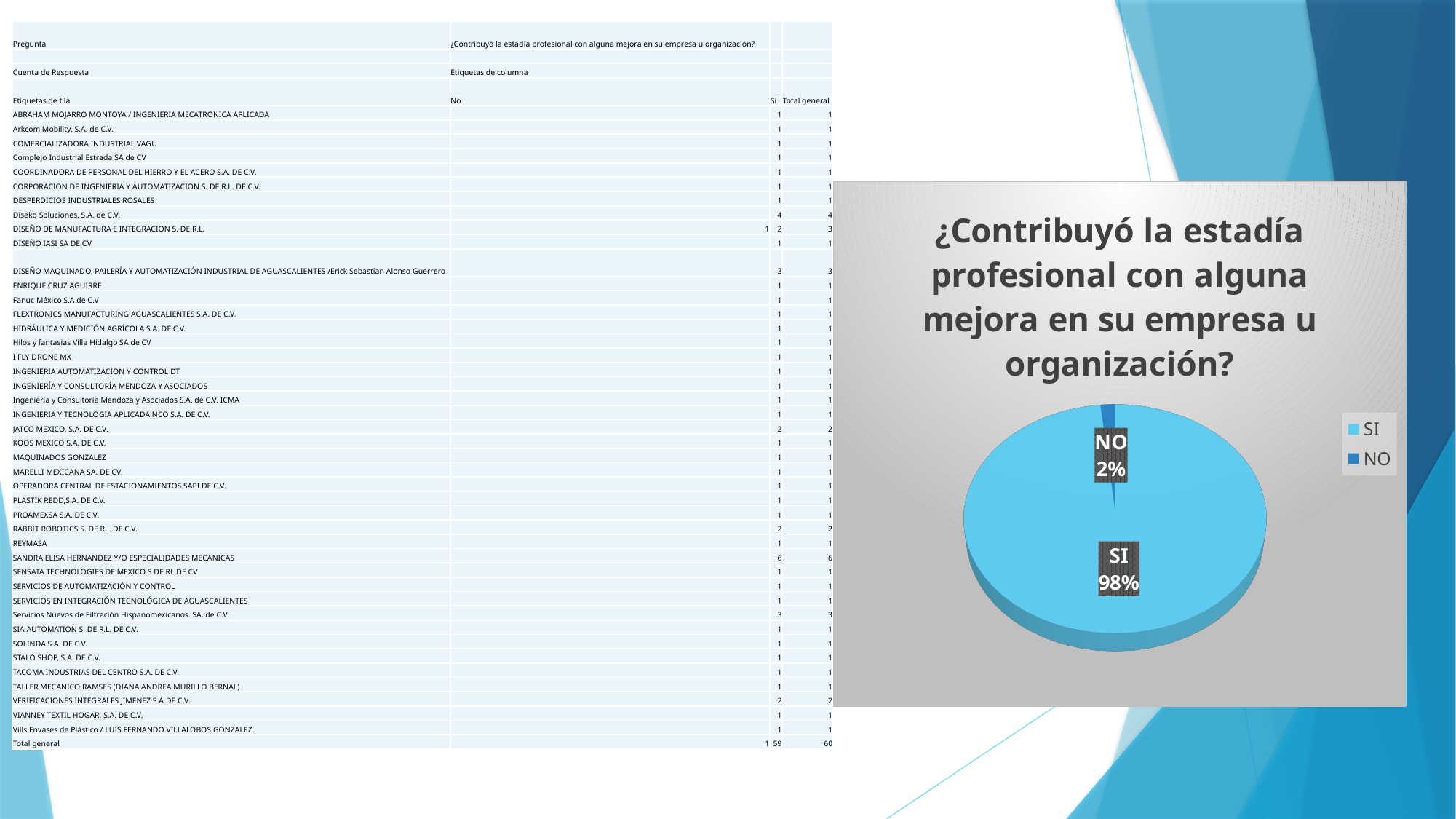
What percentage of the pie chart is labelled SI? 98% What percentage of the pie chart is labelled NO? 2% What kind of chart is shown on the slide? pie chart What is the title of the pie chart? ¿Contribuyó la estadía profesional con alguna mejora en su empresa u organización? How many slices does the pie chart have? 2 Which slice of the pie chart is the largest? SI Which slice of the pie chart is the smallest? NO What is the difference in percentage points between the SI slice and the NO slice? 96 How many entries does the pie chart legend list? 2 Which slice is larger, SI or NO? SI Is the share of the SI slice greater or less than 50%? greater Which legend entry is shown in light blue? SI